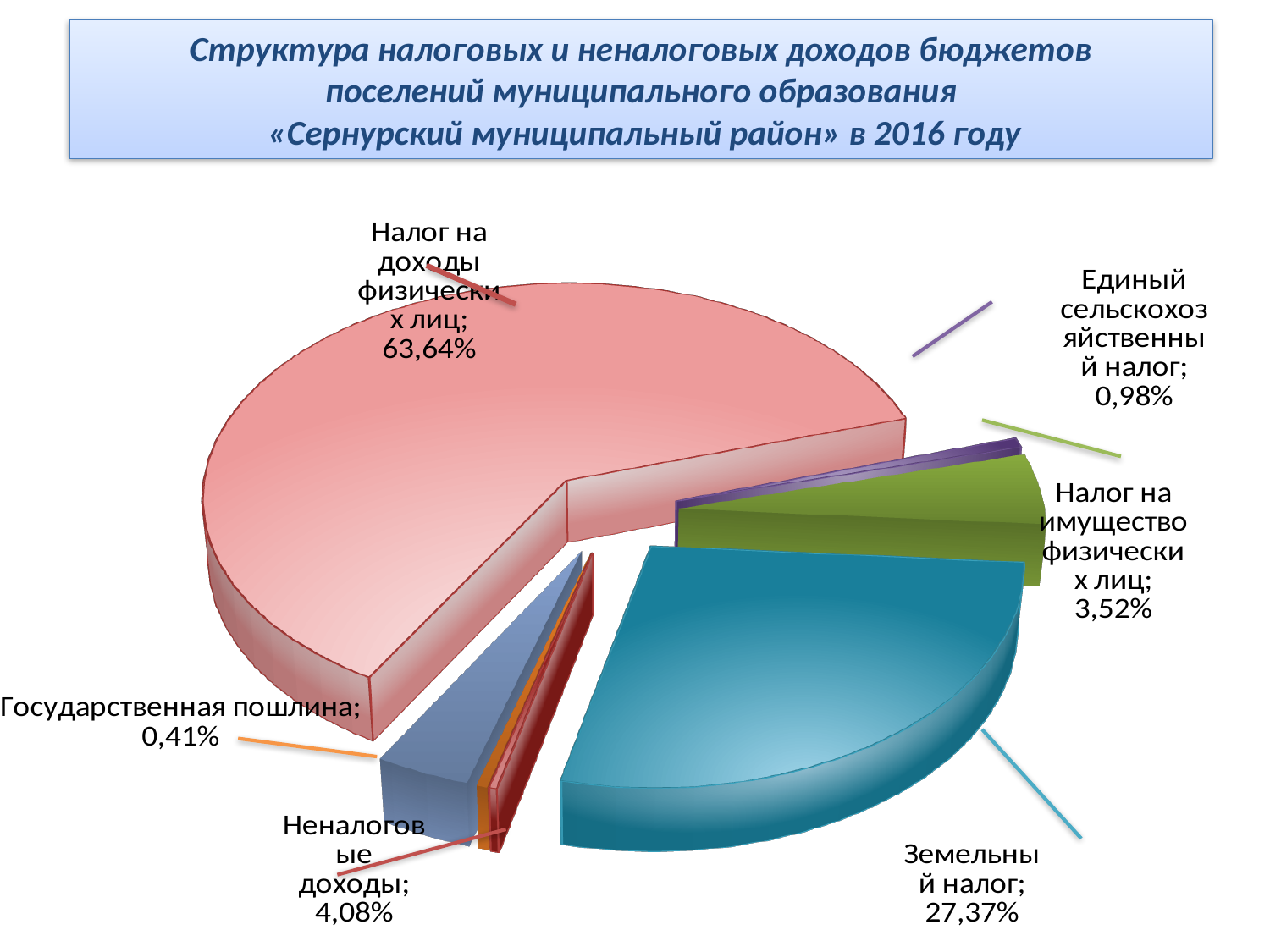
Which is larger: the share for "Неналоговые доходы" or for "Налог на имущество физических лиц"? Неналоговые доходы Which category has the largest share of the pie? Налог на доходы физических лиц What value is shown for "Налог на имущество физических лиц"? 3,52% What value is shown for "Единый сельскохозяйственный налог"? 0,98% What is the difference between the shares of "Налог на доходы физических лиц" and "Земельный налог"? 36,27% What value is shown for "Государственная пошлина"? 0,41% What share of the pie is labelled for "Налог на доходы физических лиц"? 63,64% What value is shown for "Неналоговые доходы"? 4,08% What kind of chart is shown on the slide? Pie chart What value is shown for "Земельный налог"? 27,37% How many slices does the pie chart have? 7